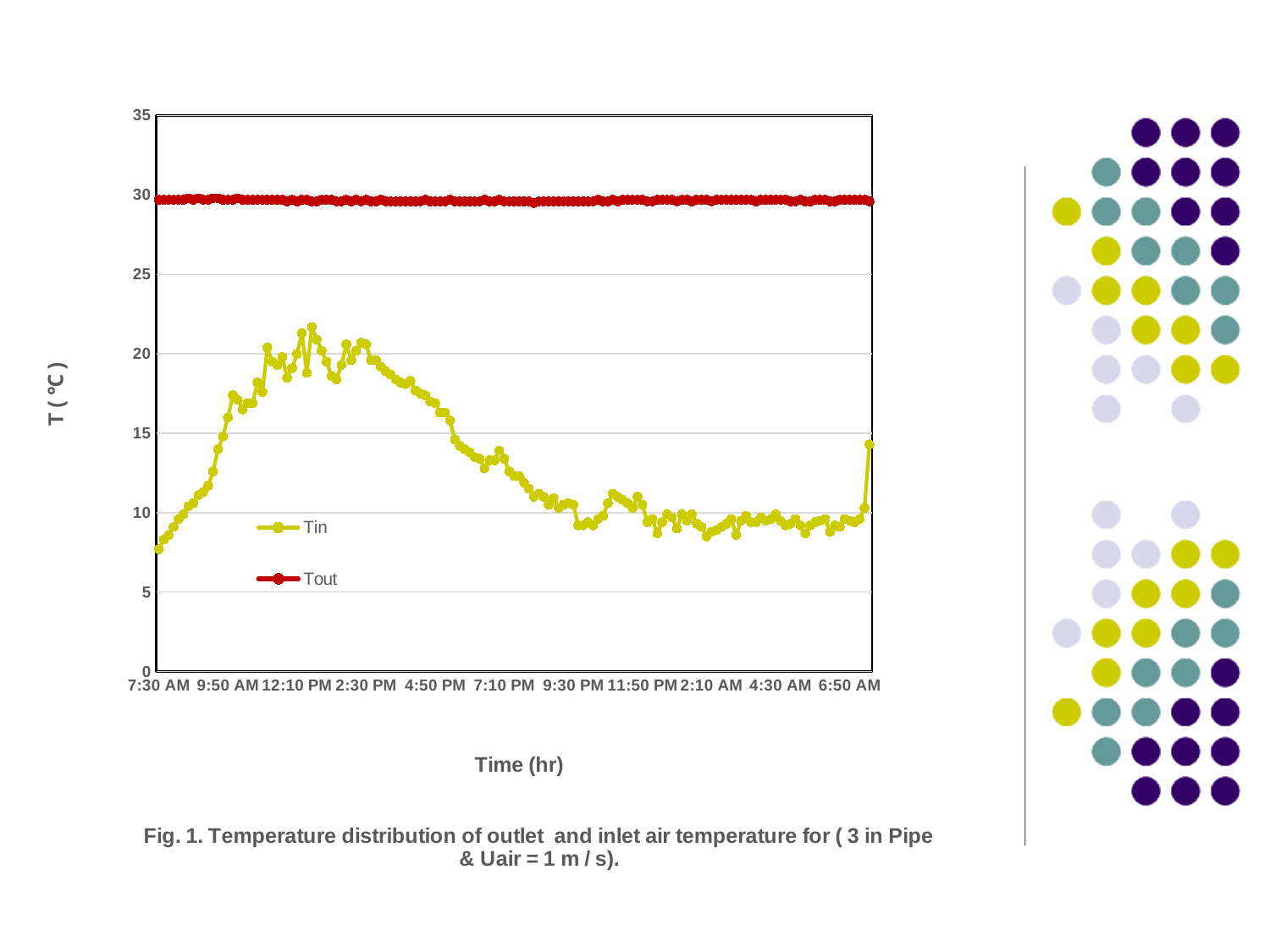
How many series does the legend list? 2 What are the two series named in the legend? Tin and Tout Is the value of Tout at 2:30 PM greater or less than 25? greater Does Tin rise or fall between 7:30 AM and 12:10 PM? rise Is the highest value reached by Tin greater or less than 25? less What kind of chart is shown on the slide? line chart Is the value of Tin at 2:10 AM greater or less than 15? less Which series has the higher value at 4:50 PM, Tin or Tout? Tout What is the title of the x axis? Time (hr) Does Tin rise or fall between 2:30 PM and 9:30 PM? fall